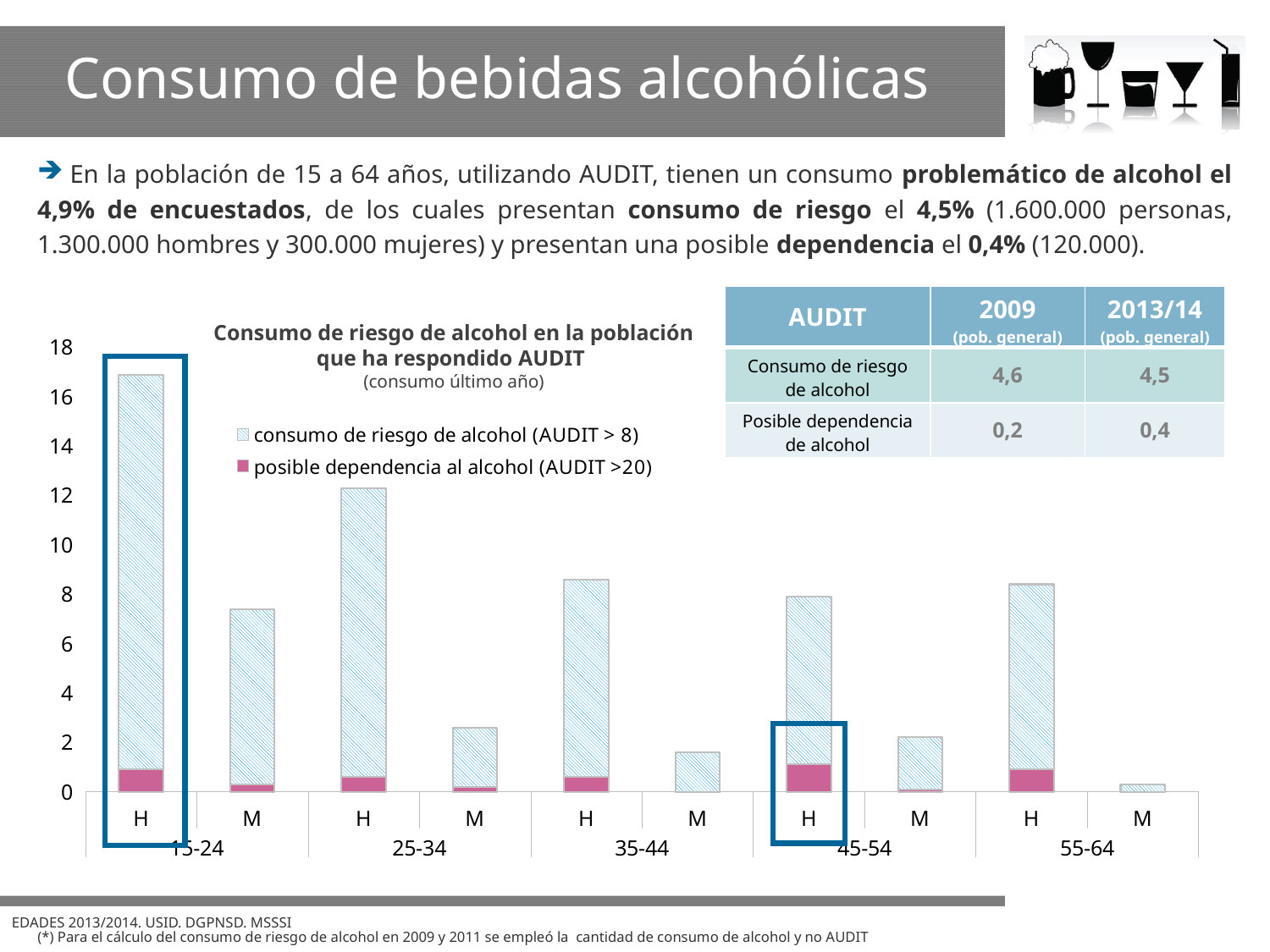
What is the title of the chart? Consumo de riesgo de alcohol en la población que ha respondido AUDIT (consumo último año) Which bar is the tallest in the chart? H, 15-24 How many age groups are shown along the x axis of the chart? 5 Is the total value for H in the 25-34 age group greater or less than 10? greater Which is larger, the bar for M in 25-34 or the bar for M in 35-44? M in 25-34 Is the total value for H in the 15-24 age group greater or less than 14? greater How many bars are plotted in the chart? 10 Which is larger, the bar for H in 15-24 or the bar for H in 25-34? H in 15-24 Is the total value for M in the 15-24 age group greater or less than 8? less What kind of chart is shown on the slide? bar chart How many series does the chart legend list? 2 Which bar is the shortest in the chart? M, 55-64